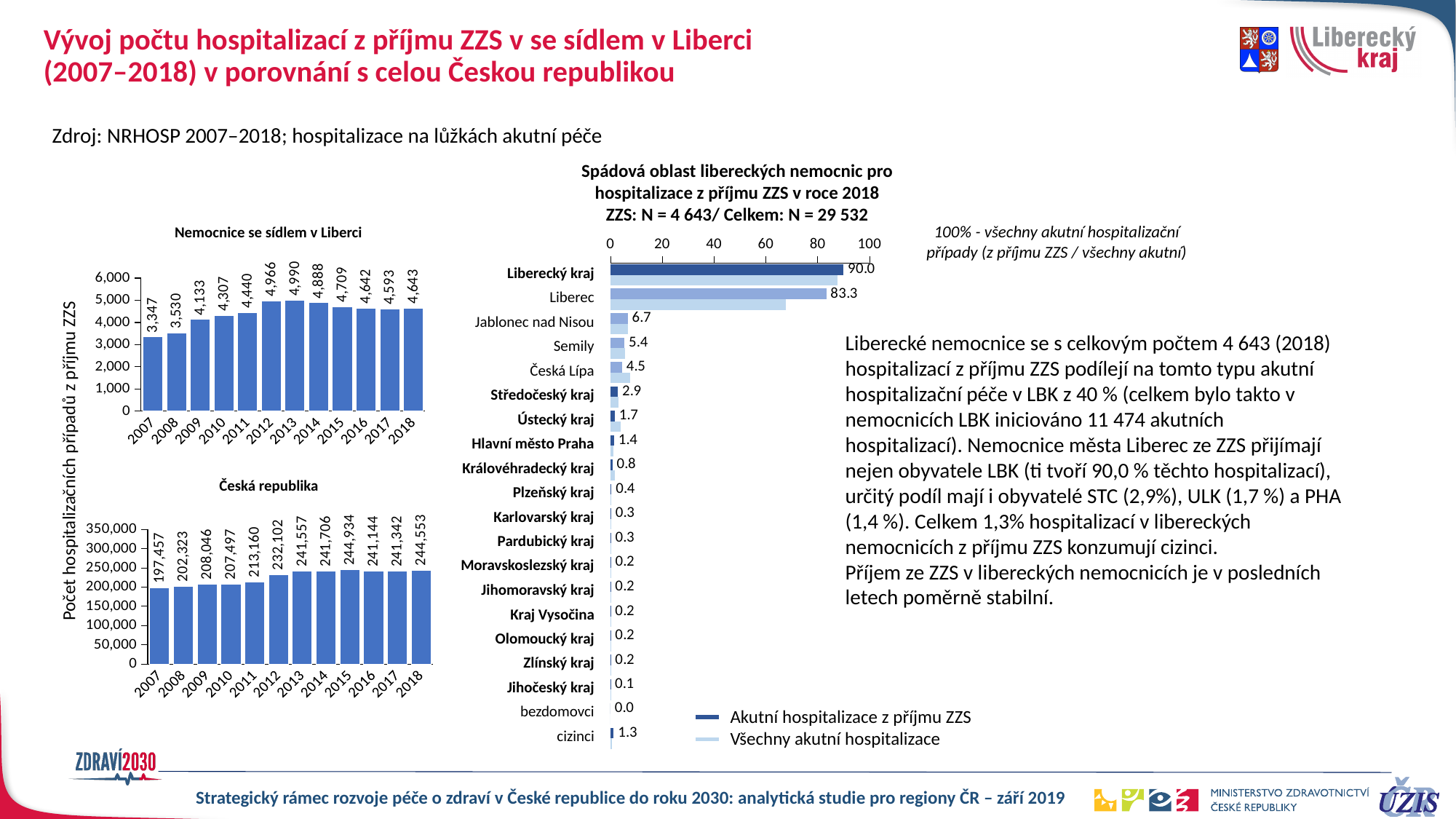
In the chart 'Česká republika', what is the value for 2015? 244,934 In the chart 'Nemocnice se sídlem v Liberci', what is the value for 2018? 4,643 In the chart 'Nemocnice se sídlem v Liberci', which year has the highest value? 2013 How many years are shown in the chart 'Česká republika'? 12 In the chart 'Nemocnice se sídlem v Liberci', what is the difference between the values for 2018 and 2007? 1,296 How many series does the legend of the chart 'Spádová oblast libereckých nemocnic pro hospitalizace z příjmu ZZS v roce 2018' list? 2 In the chart 'Spádová oblast libereckých nemocnic pro hospitalizace z příjmu ZZS v roce 2018', what is the labelled value for Jablonec nad Nisou? 6.7 In the chart 'Česká republika', which is larger, the value for 2012 or the value for 2013? 2013 In the chart 'Česká republika', which year has the lowest value? 2007 In the chart 'Spádová oblast libereckých nemocnic pro hospitalizace z příjmu ZZS v roce 2018', which category has the highest labelled value? Liberecký kraj In the chart 'Nemocnice se sídlem v Liberci', which year has the lowest value? 2007 What type of chart is 'Nemocnice se sídlem v Liberci'? bar chart